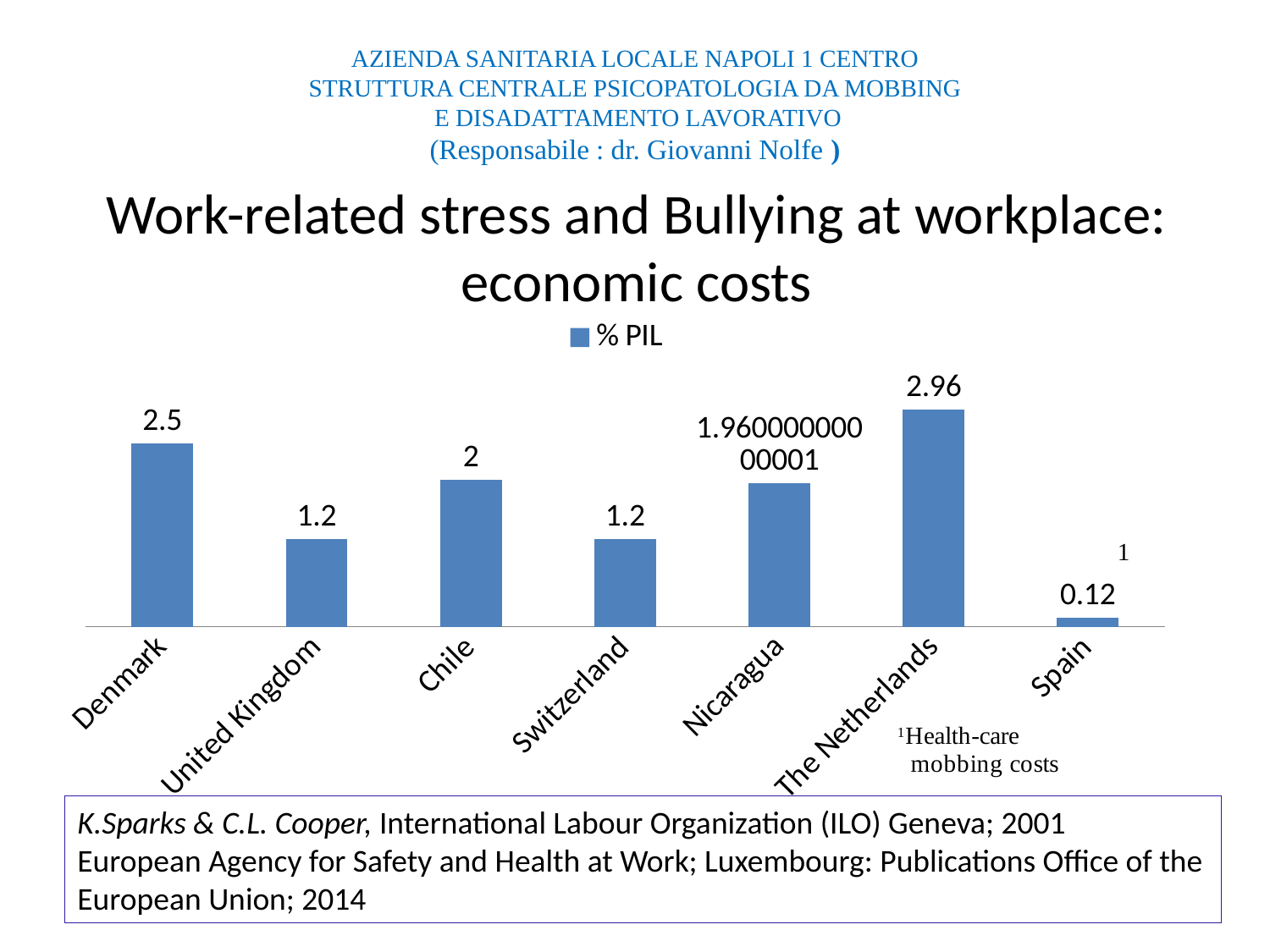
Which is larger, the value for Chile or the value for Switzerland? Chile What series name does the legend show? % PIL What is the difference between the values for The Netherlands and Denmark? 0.46 What is the value for The Netherlands? 2.96 What is the value for Chile? 2 What is the value for Denmark? 2.5 How many countries are shown in the chart? 7 What is the value for Spain? 0.12 Which country has the highest value? The Netherlands What is the difference between the values for Denmark and United Kingdom? 1.3 Which country has the lowest value? Spain What kind of chart is shown on the slide? Bar chart